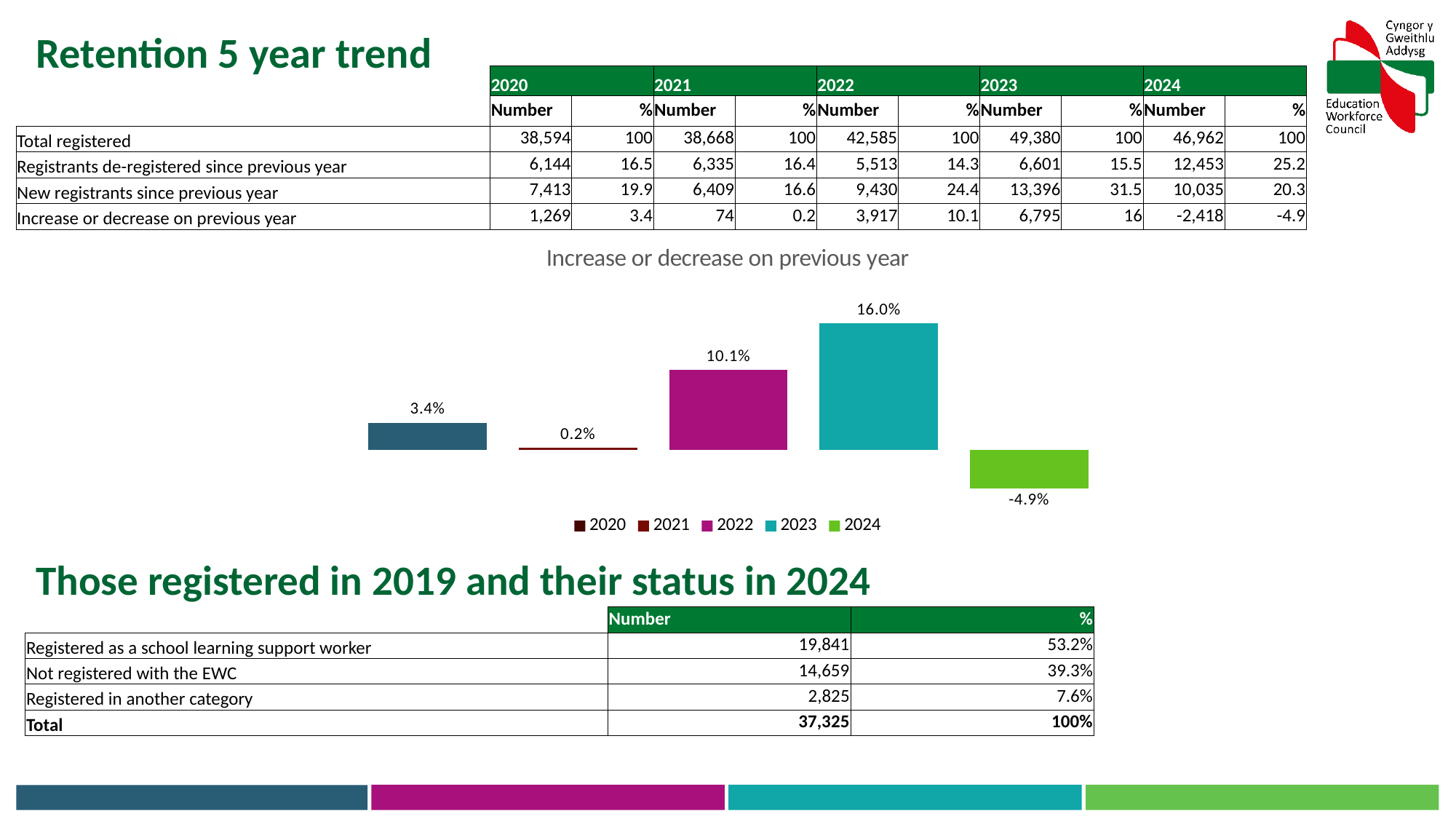
What kind of chart is shown on the slide? Bar chart What is the difference between the values for 2023 and 2022 in the chart? 5.9% Which year has the highest value in the chart? 2023 Which year has the lowest value in the chart? 2024 What is the value for 2024 in the chart? -4.9% How many entries does the chart's legend list? 5 Which is larger in the chart, the value for 2020 or the value for 2022? 2022 What is the value for 2020 in the chart? 3.4% What is the value for 2023 in the chart? 16.0% What is the value for 2021 in the chart? 0.2% How many bars are plotted in the chart? 5 What is the title of the chart? Increase or decrease on previous year